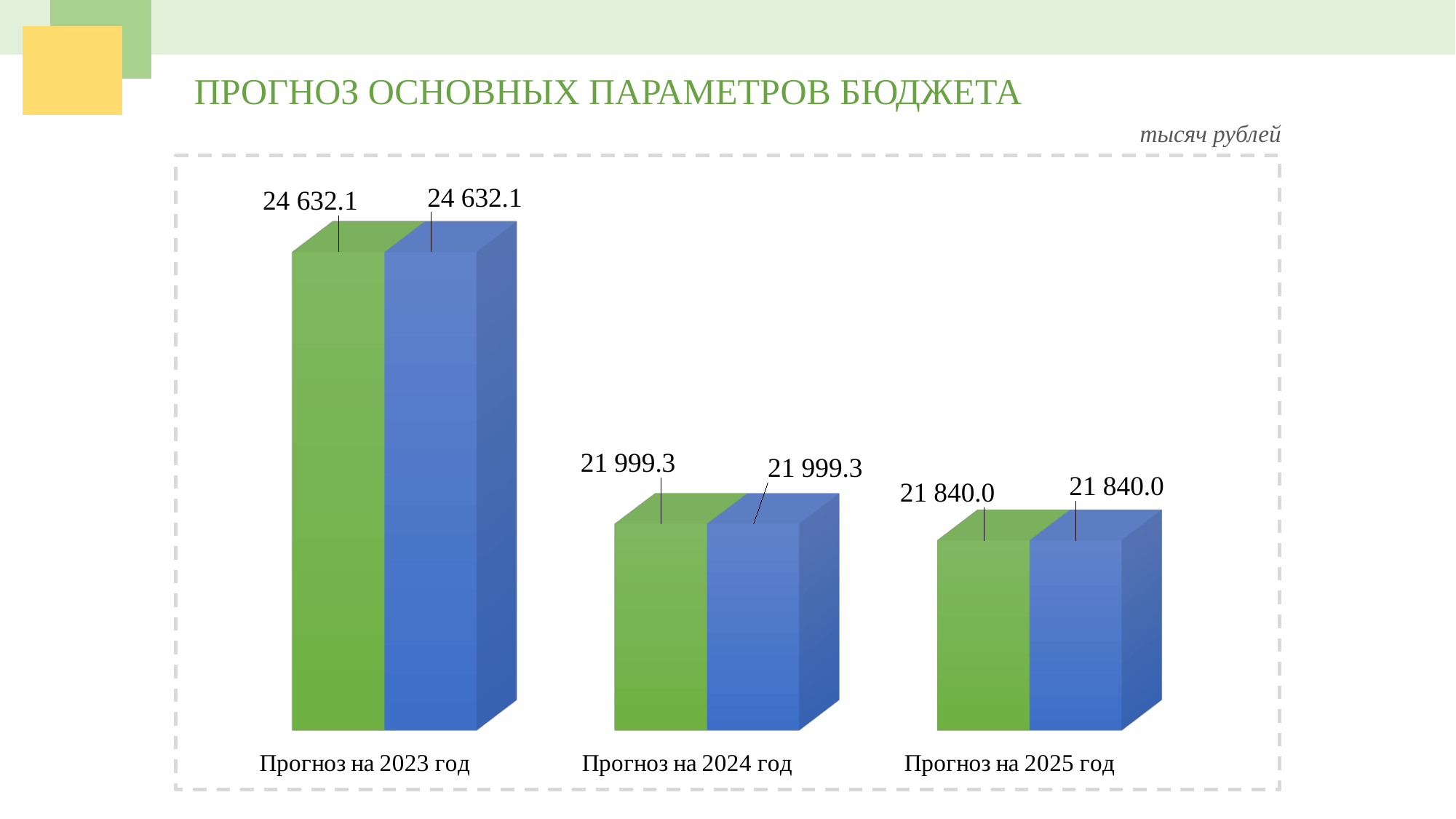
Which category has the highest green bar? Прогноз на 2023 год What kind of chart is shown on the slide? Bar chart Which is larger: the green bar for Прогноз на 2024 год or the green bar for Прогноз на 2025 год? Прогноз на 2024 год What is the difference between the blue bar values for Прогноз на 2024 год and Прогноз на 2025 год? 159.3 What is the difference between the green bar values for Прогноз на 2023 год and Прогноз на 2024 год? 2 632.8 Do the values rise or fall from Прогноз на 2023 год to Прогноз на 2025 год? Fall Which category has the lowest blue bar? Прогноз на 2025 год What is the value of the green bar for Прогноз на 2023 год? 24 632.1 What is the value of the green bar for Прогноз на 2025 год? 21 840.0 What is the value of the blue bar for Прогноз на 2024 год? 21 999.3 How many categories are shown on the x axis? 3 What unit is indicated above the chart? тысяч рублей